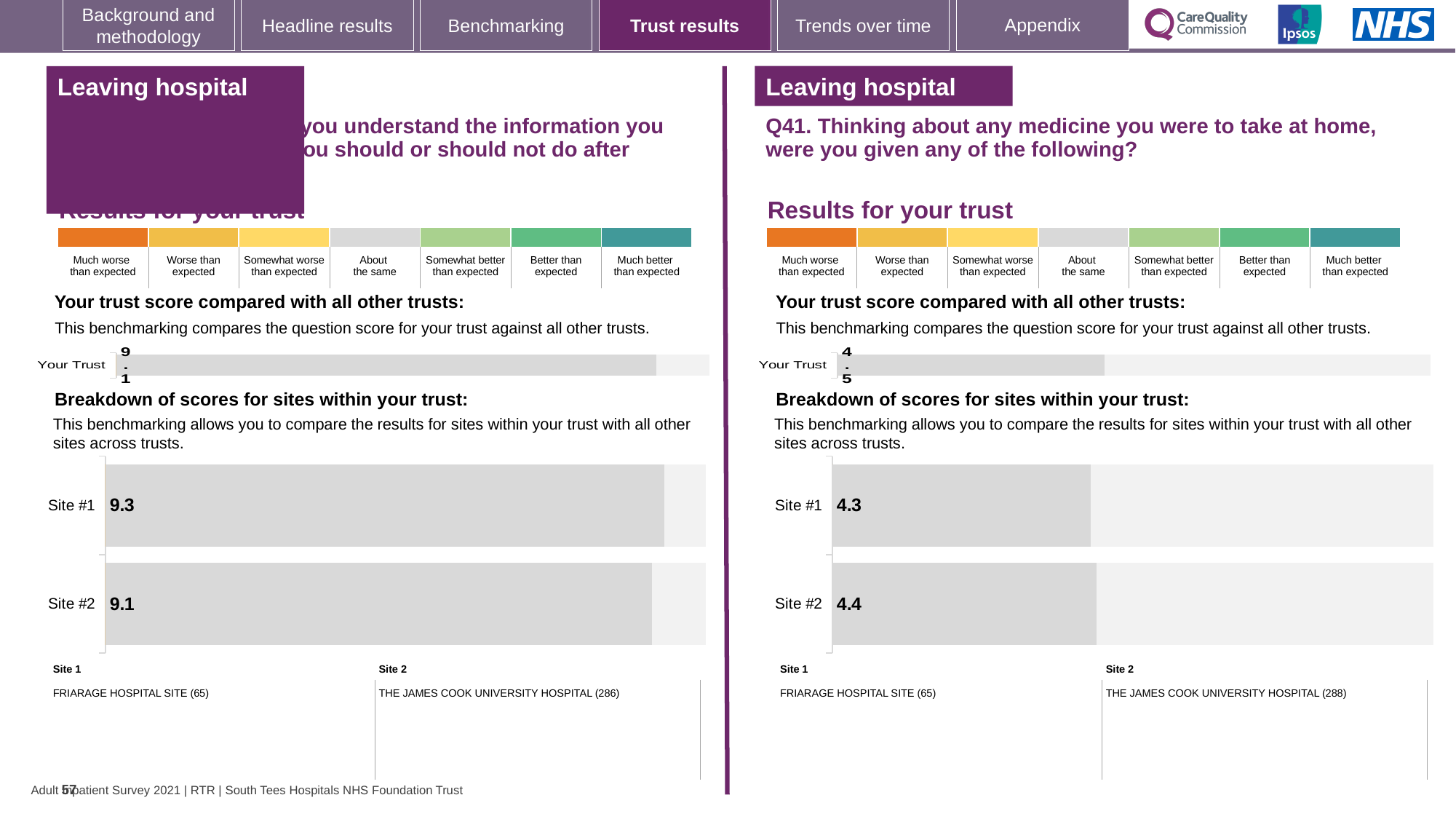
In the Q41 site breakdown chart on the right-hand side, what is the score for Site #1? 4.3 On the left-hand side of the slide, which site has the higher score in the site breakdown chart? Site #1 In the Q41 site breakdown chart on the right-hand side, what is the score for Site #2? 4.4 In the Q41 trust score chart on the right-hand side, what is the 'Your Trust' score? 4.5 On the left-hand side of the slide, what is the score for Site #2 in the breakdown of scores for sites within your trust? 9.1 In the Q41 site breakdown chart on the right-hand side, which site has the lower score? Site #1 On the left-hand side of the slide, what is the score for Site #1 in the breakdown of scores for sites within your trust? 9.3 What type of chart is used for the breakdown of scores for sites within your trust on the left-hand side of the slide? Bar chart How many sites are shown in the Q41 site breakdown chart on the right-hand side of the slide? 2 On the left-hand side of the slide, what is the 'Your Trust' score shown in the trust score chart? 9.1 In the Q41 site breakdown chart on the right-hand side, what is the difference between the Site #2 and Site #1 scores? 0.1 On the left-hand side of the slide, what is the difference between the Site #1 and Site #2 scores in the site breakdown chart? 0.2